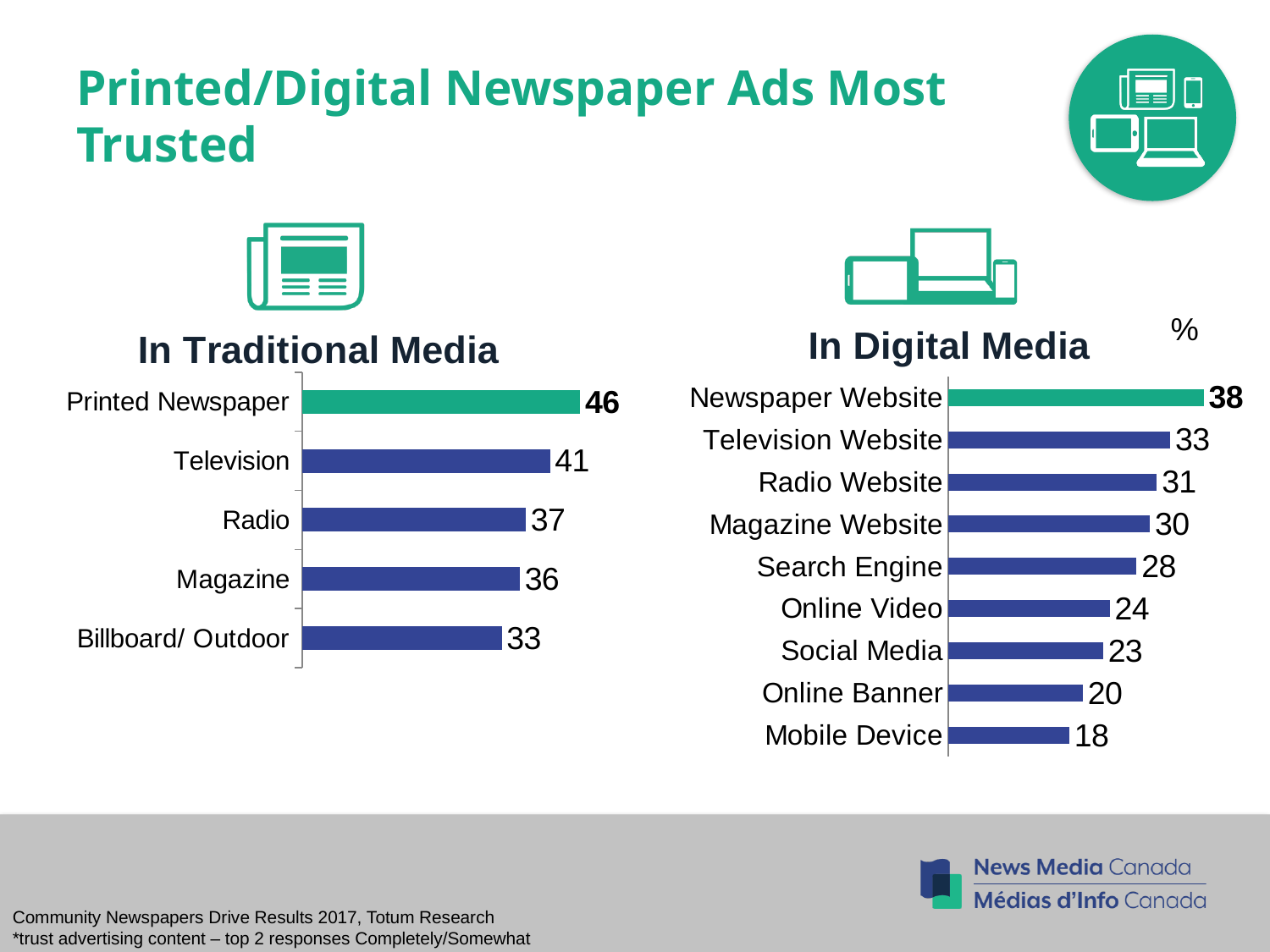
What type of chart is the 'In Digital Media' chart? Bar chart In the 'In Digital Media' chart, what is the difference between Newspaper Website and Online Banner? 18 In the 'In Traditional Media' chart, what is the value for Printed Newspaper? 46 In the 'In Digital Media' chart, which category has the highest value? Newspaper Website In the 'In Traditional Media' chart, what is the difference between Printed Newspaper and Television? 5 In the 'In Digital Media' chart, what is the value for Mobile Device? 18 In the 'In Digital Media' chart, which is larger, Online Video or Social Media? Online Video In the 'In Digital Media' chart, what is the value for Search Engine? 28 In the 'In Traditional Media' chart, which category has the lowest value? Billboard/ Outdoor In the 'In Traditional Media' chart, what is the value for Radio? 37 In the 'In Digital Media' chart, how many categories are shown? 9 In the 'In Traditional Media' chart, how many categories are shown? 5